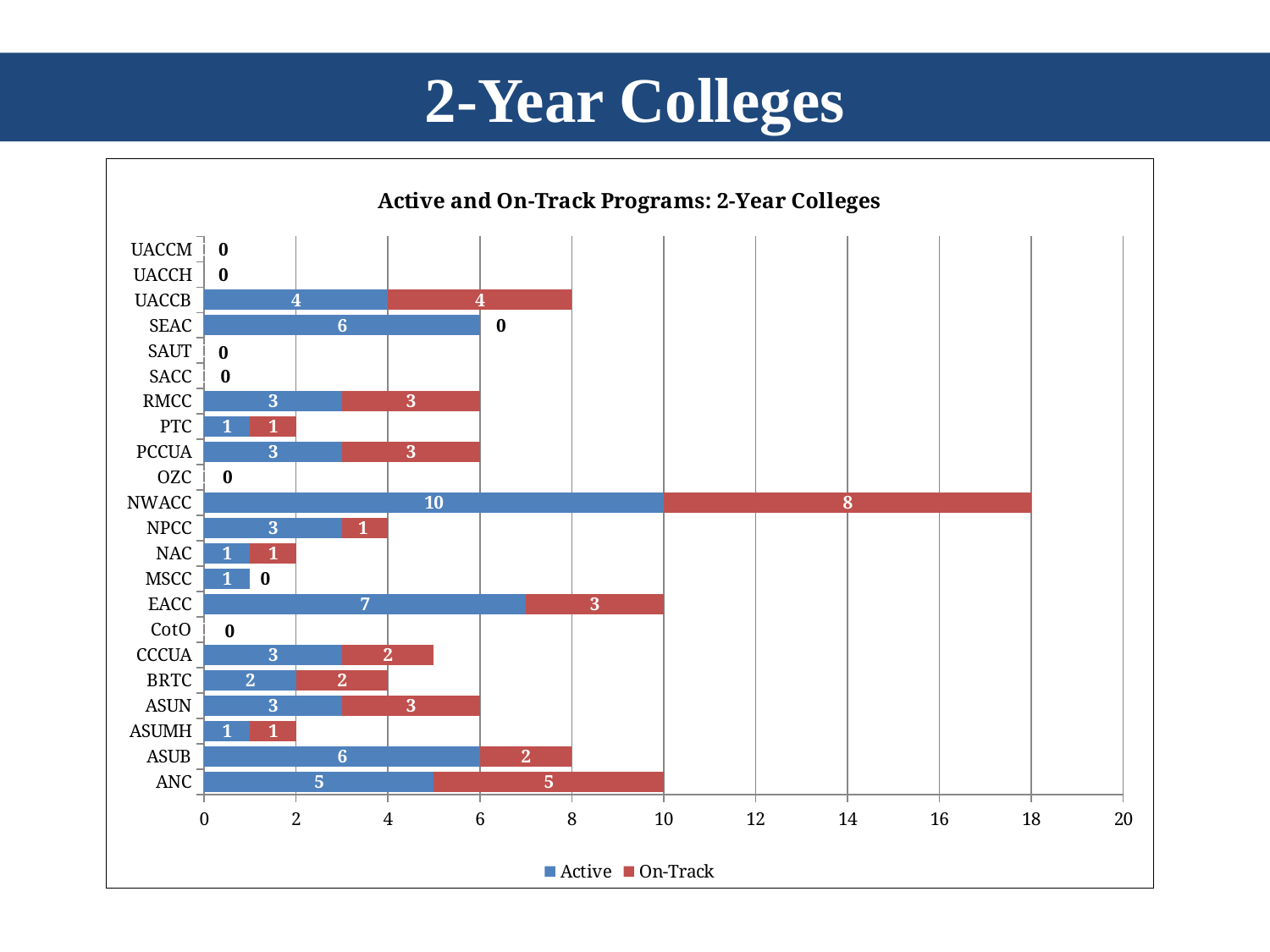
What is the difference between the Active values for EACC and ASUB? 1 What is the Active value for NWACC? 10 What is the On-Track value for SEAC? 0 How many colleges are listed on the vertical axis? 22 Which is larger, the On-Track value for UACCB or the On-Track value for ASUB? UACCB What is the On-Track value for EACC? 3 What type of chart is shown on the slide? stacked bar chart Which college has the highest Active value? NWACC How many series does the legend list? 2 What is the title of the chart? Active and On-Track Programs: 2-Year Colleges What is the total of the stacked bar for ANC? 10 What is the total of the stacked bar for NWACC? 18